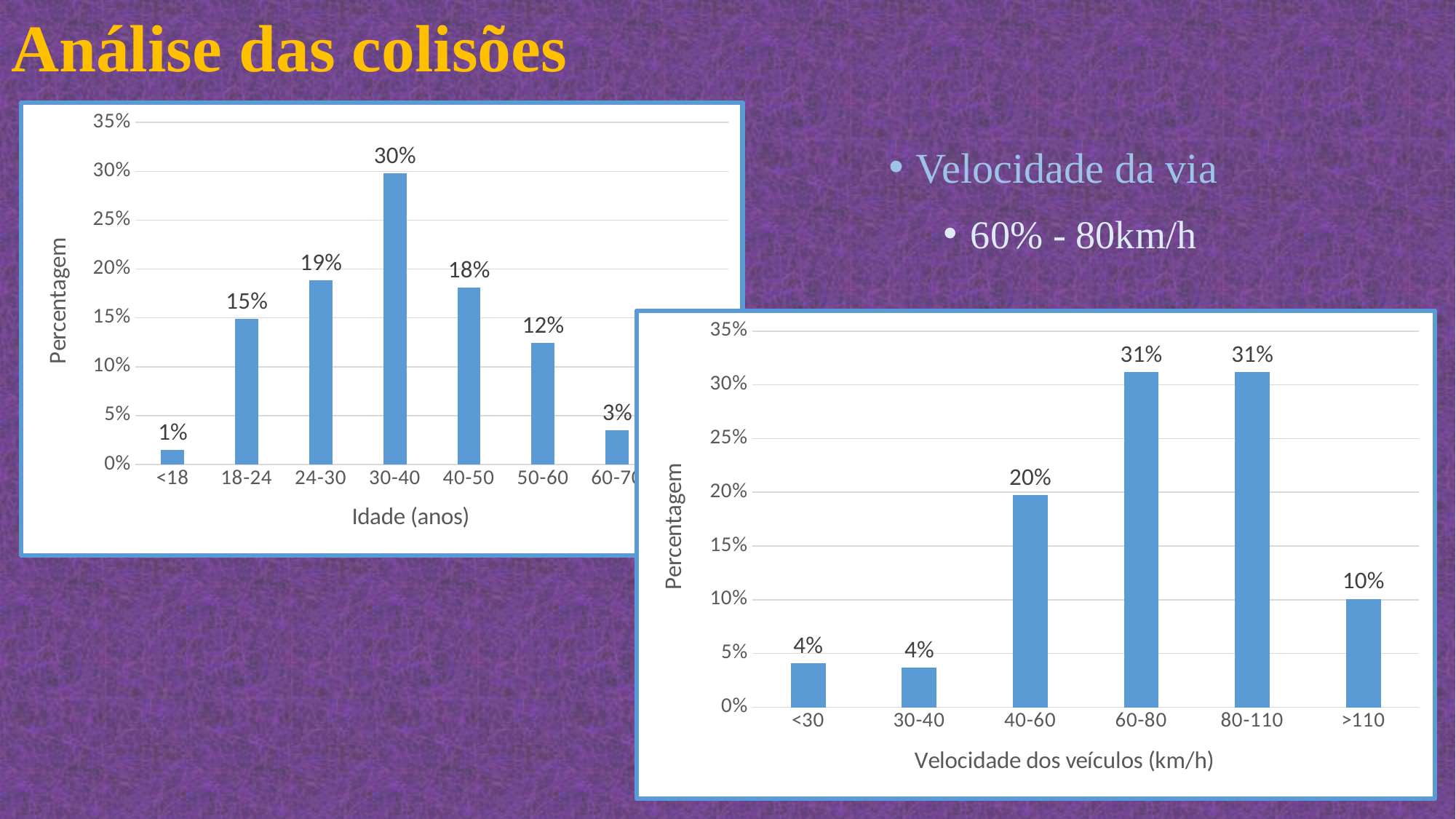
What kind of chart is the right chart (Velocidade dos veículos (km/h))? Bar chart In the left chart (Idade (anos)), what is the percentage for the 30-40 age group? 30% In the right chart (Velocidade dos veículos (km/h)), what is the percentage for the 40-60 km/h range? 20% In the right chart (Velocidade dos veículos (km/h)), what is the difference between the percentages for 60-80 and 40-60? 11% In the right chart (Velocidade dos veículos (km/h)), which is larger, the percentage for 80-110 or for >110? 80-110 In the left chart (Idade (anos)), which age group has the highest percentage? 30-40 In the left chart (Idade (anos)), what is the percentage for the <18 age group? 1% What is the y-axis label of the left chart (Idade (anos))? Percentagem In the right chart (Velocidade dos veículos (km/h)), what is the percentage for the >110 km/h range? 10% In the right chart (Velocidade dos veículos (km/h)), how many speed ranges are shown on the x axis? 6 In the left chart (Idade (anos)), which is larger, the percentage for 40-50 or for 50-60? 40-50 In the left chart (Idade (anos)), what is the difference between the percentages for 24-30 and 18-24? 4%